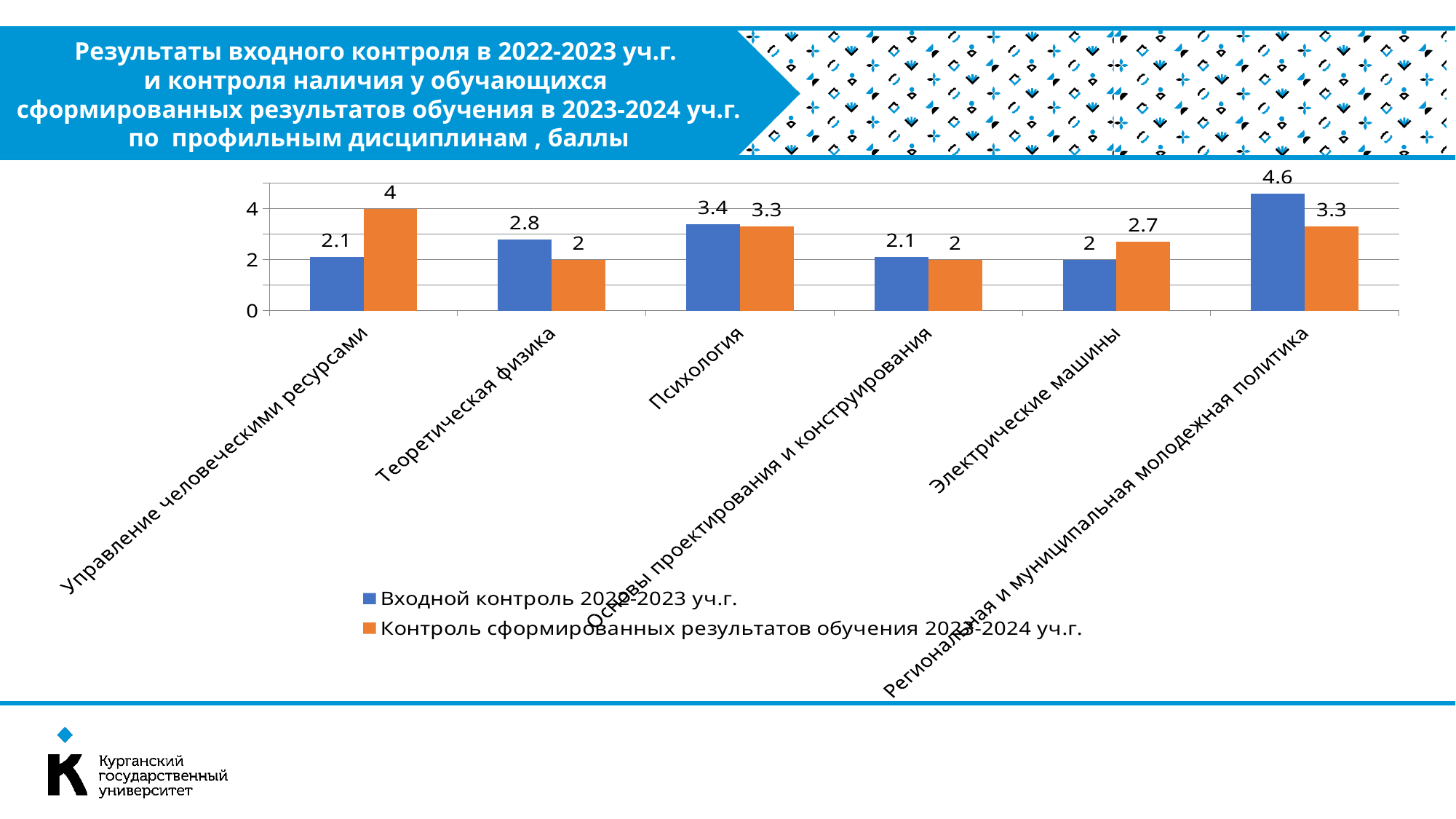
What is the value of 'Контроль сформированных результатов обучения 2023-2024 уч.г.' for 'Управление человеческими ресурсами'? 4 What is the difference between the two series for 'Региональная и муниципальная молодежная политика'? 1.3 What is the value of 'Входной контроль 2022-2023 уч.г.' for 'Психология'? 3.4 What kind of chart is shown on the slide? Bar chart Which colour represents 'Контроль сформированных результатов обучения 2023-2024 уч.г.' in the chart? Orange What is the value of 'Контроль сформированных результатов обучения 2023-2024 уч.г.' for 'Электрические машины'? 2.7 Which category has the lowest value for 'Входной контроль 2022-2023 уч.г.'? Электрические машины For 'Теоретическая физика', which series has the larger value? Входной контроль 2022-2023 уч.г. What is the difference between the two series for 'Управление человеческими ресурсами'? 1.9 How many categories are shown on the x axis? 6 Which category has the highest value for 'Входной контроль 2022-2023 уч.г.'? Региональная и муниципальная молодежная политика How many series does the legend list? 2